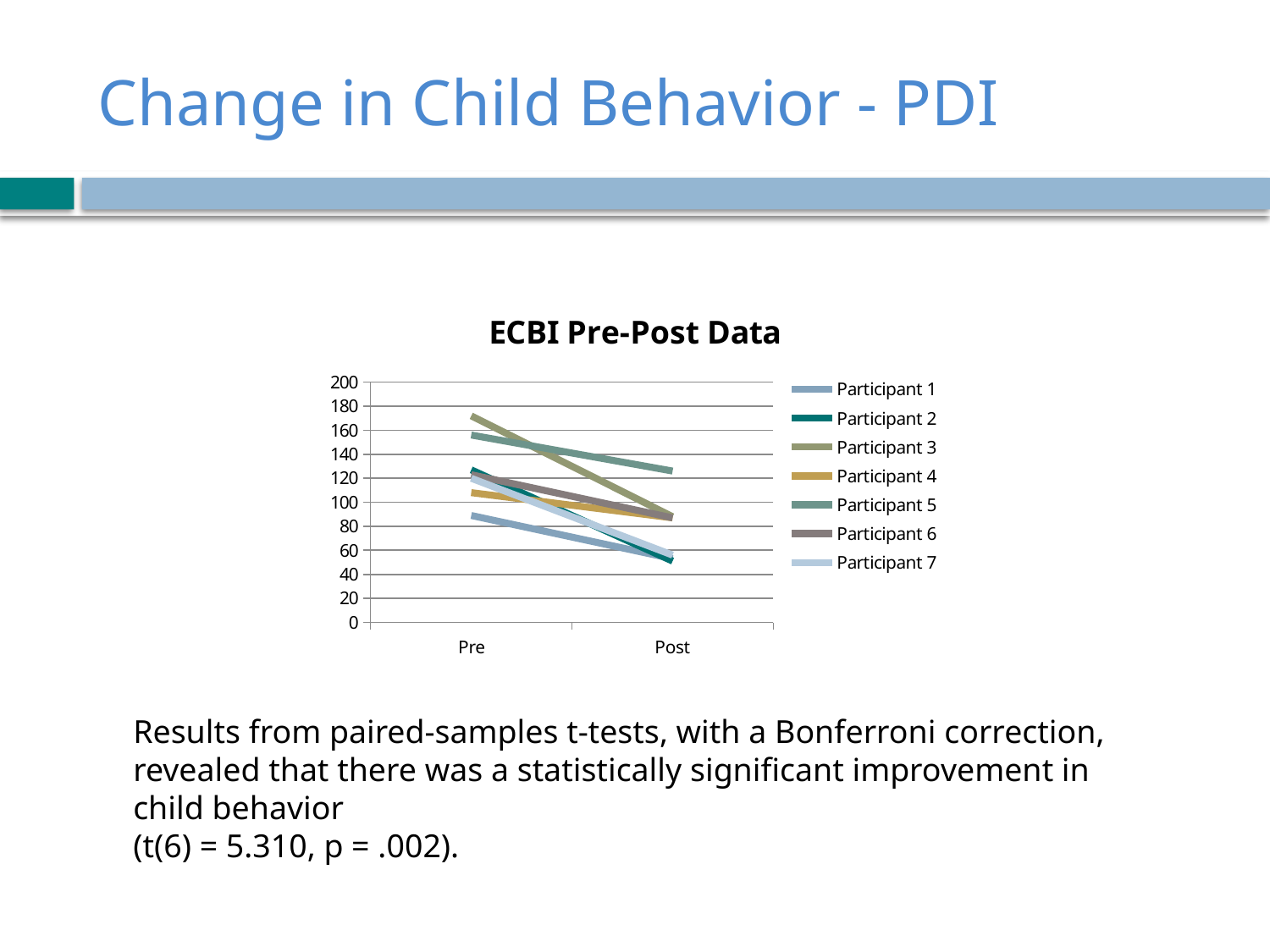
Which participant has the lowest value at Pre? Participant 1 Is the Pre value for Participant 1 greater or less than 100? less Which participant has the highest value at Pre? Participant 3 What kind of chart is shown on the slide? Line chart Is the Pre value for Participant 3 greater or less than 160? greater Is the Post value for Participant 5 greater or less than 120? greater At Post, which is larger: the value for Participant 5 or the value for Participant 6? Participant 5 How many series does the legend list? 7 Do the values for Participant 2 rise or fall from Pre to Post? fall Which participant has the highest value at Post? Participant 5 How many categories are shown on the x axis? 2 What is the title of the chart? ECBI Pre-Post Data